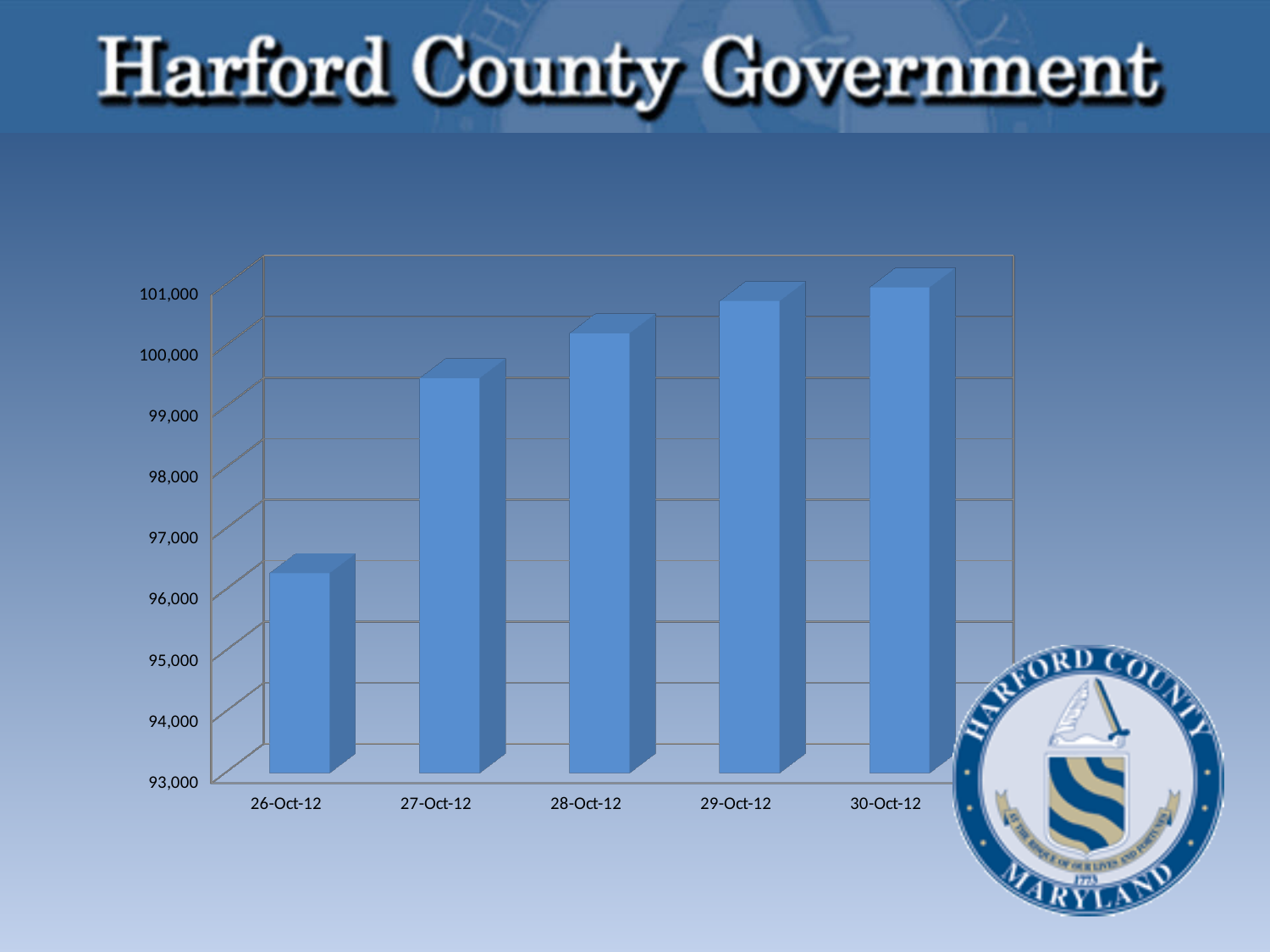
Is the value for 26-Oct-12 greater or less than 96,000? greater What is the lowest value shown on the vertical axis of the chart? 93,000 Is the value for 30-Oct-12 greater or less than 100,000? greater What kind of chart is shown on the slide? bar chart Is the value for 27-Oct-12 greater or less than 100,000? less Which date has the highest value in the chart? 30-Oct-12 Which date has the lowest value in the chart? 26-Oct-12 How many dates are plotted on the x axis of the chart? 5 Which is larger, the value for 27-Oct-12 or the value for 28-Oct-12? 28-Oct-12 Do the values rise or fall from 26-Oct-12 to 30-Oct-12? rise